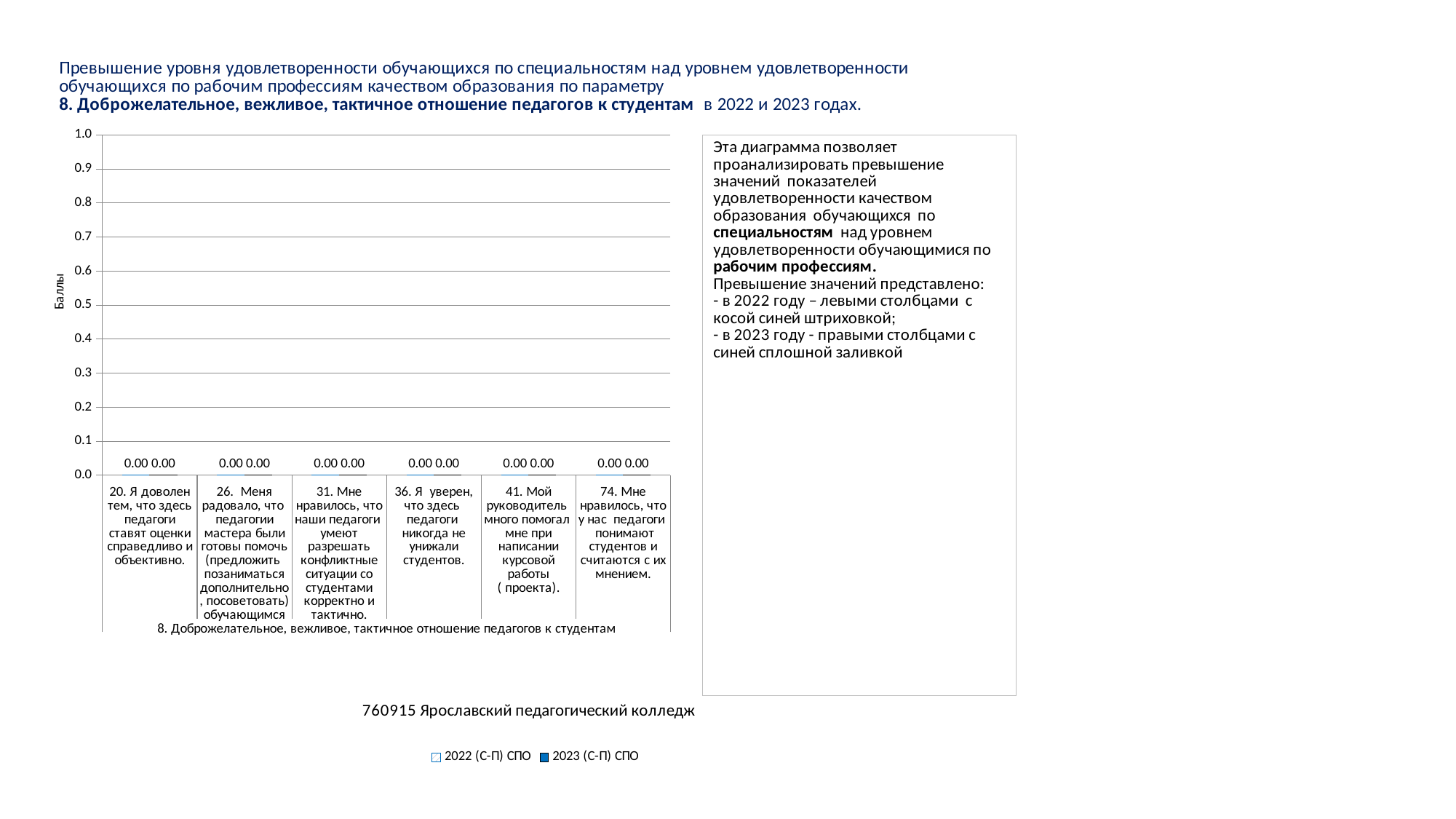
What is the value for the 2023 (С-П) СПО series for category "36. Я уверен, что здесь педагоги никогда не унижали студентов."? 0.00 Do the values of the 2022 (С-П) СПО series rise, fall, or stay flat across the categories on the x axis? stay flat What is the label of the vertical axis of the chart? Баллы What kind of chart is shown on the slide? Bar chart What is the value for the 2022 (С-П) СПО series for category "20. Я доволен тем, что здесь педагоги ставят оценки справедливо и объективно."? 0.00 How many series does the chart legend list? 2 What is the value for the 2022 (С-П) СПО series for category "41. Мой руководитель много помогал мне при написании курсовой работы ( проекта)."? 0.00 Is the value for the 2023 (С-П) СПО series for category "26. Меня радовало, что педагогии мастера были готовы помочь (предложить позаниматься дополнительно, посоветовать) обучающимся" greater or less than 0.1? less What is the value for the 2023 (С-П) СПО series for category "74. Мне нравилось, что у нас педагоги понимают студентов и считаются с их мнением."? 0.00 What are the two series names listed in the chart legend? 2022 (С-П) СПО and 2023 (С-П) СПО How many categories are shown on the x axis of the chart? 6 What is the difference between the 2022 (С-П) СПО and 2023 (С-П) СПО values for category "31. Мне нравилось, что наши педагоги умеют разрешать конфликтные ситуации со студентами корректно и тактично."? 0.00